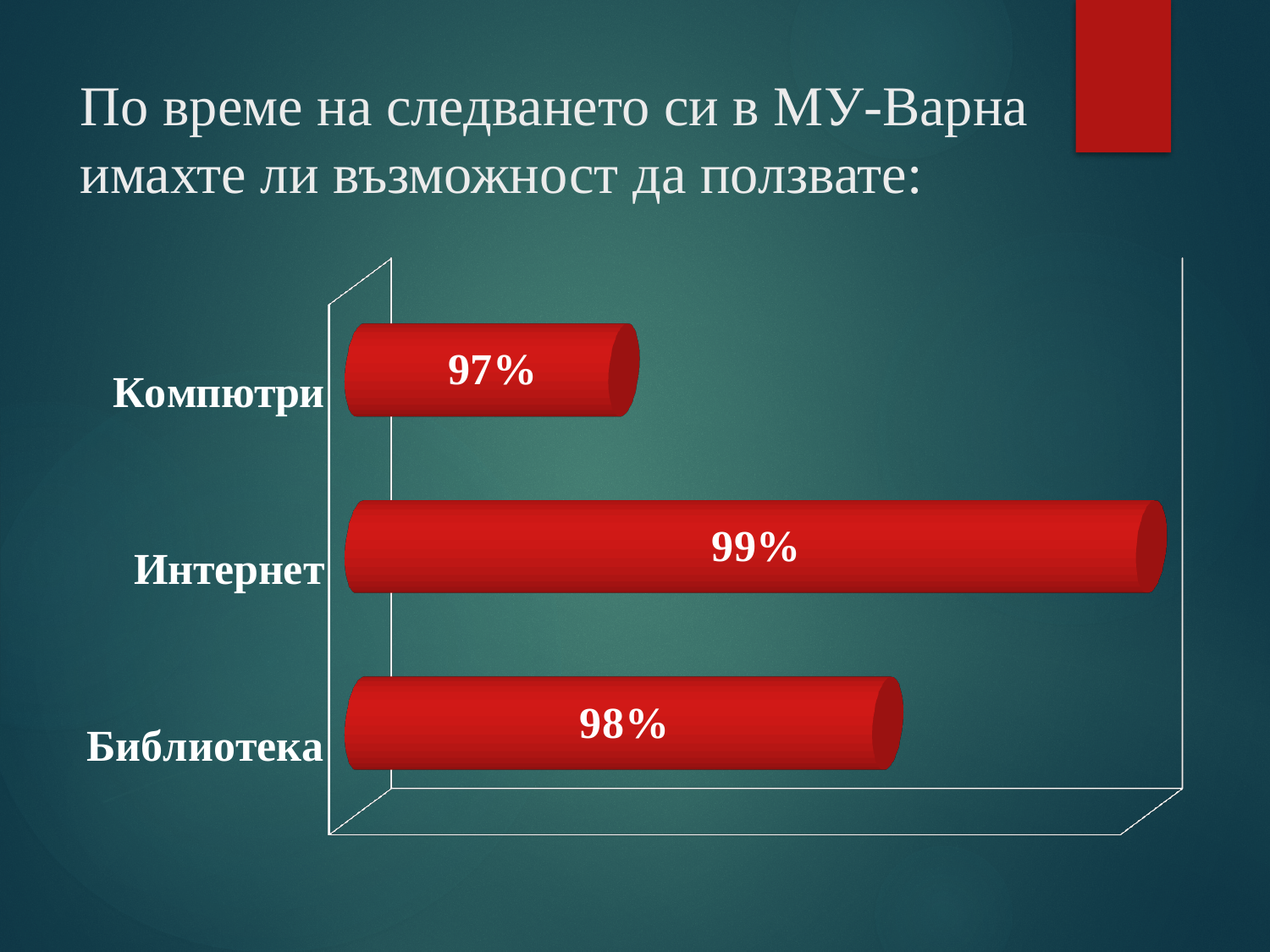
What kind of chart is shown on the slide? Bar chart What is the value for Интернет? 99% What is the difference between the values for Библиотека and Компютри? 1% What is the value for Компютри? 97% What is the difference between the values for Интернет and Компютри? 2% How many categories are shown in the chart? 3 Which category has the highest value? Интернет What is the value for Библиотека? 98% What colour are the bars in the chart? Red Which category has the lowest value? Компютри Which is larger, the value for Интернет or the value for Библиотека? Интернет Which is larger, the value for Библиотека or the value for Компютри? Библиотека